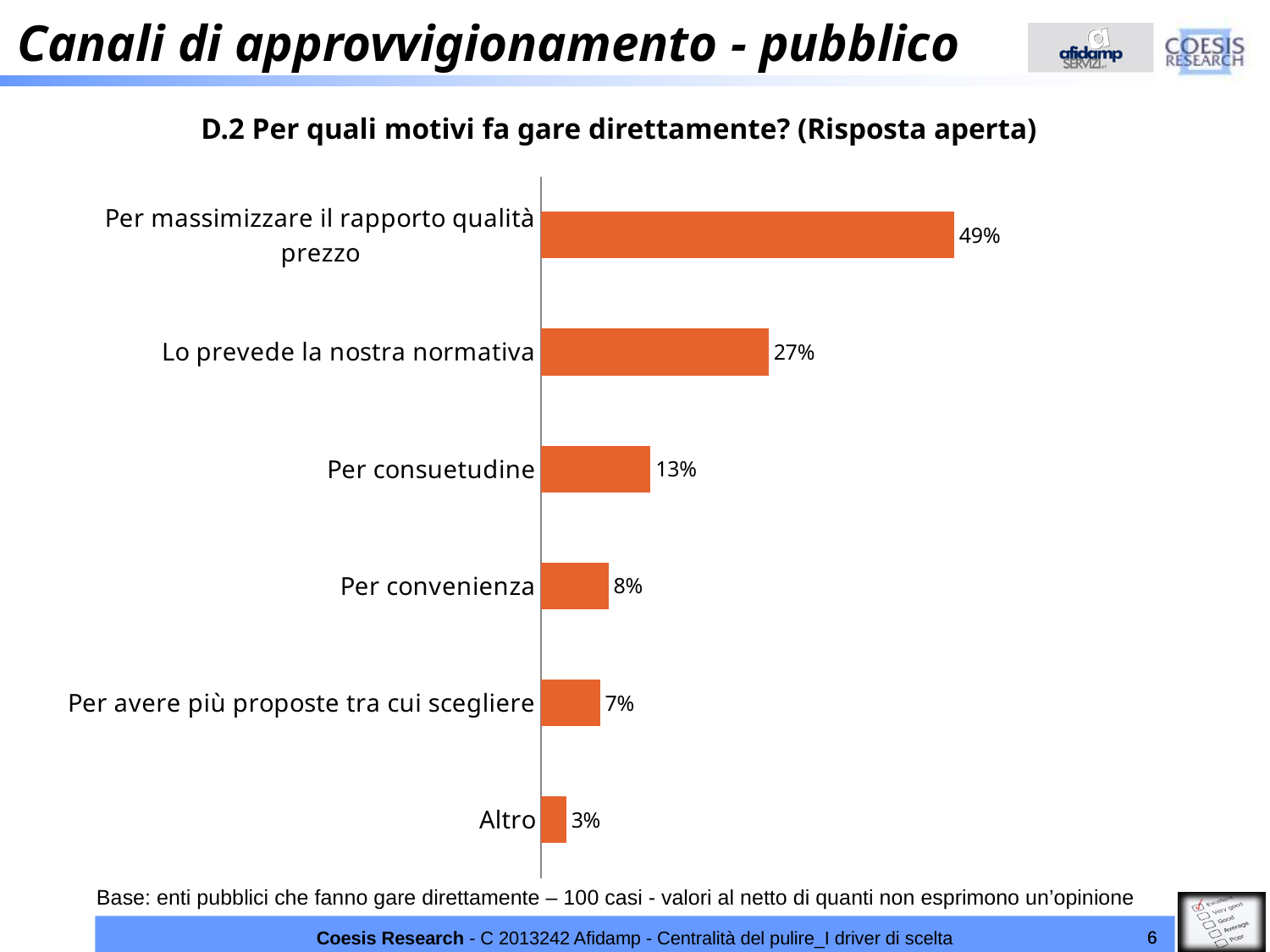
What is the value for "Per massimizzare il rapporto qualità prezzo"? 49% How many categories are shown in the chart? 6 What is the value for "Lo prevede la nostra normativa"? 27% What is the value for "Per consuetudine"? 13% What is the title of the chart? D.2 Per quali motivi fa gare direttamente? (Risposta aperta) What is the difference between the values for "Per consuetudine" and "Per convenienza"? 5% Which is larger, the value for "Per convenienza" or the value for "Per avere più proposte tra cui scegliere"? Per convenienza Which category has the lowest value? Altro What kind of chart is shown on the slide? Bar chart What is the value for "Altro"? 3% Which category has the highest value? Per massimizzare il rapporto qualità prezzo What is the difference between the values for "Per massimizzare il rapporto qualità prezzo" and "Lo prevede la nostra normativa"? 22%